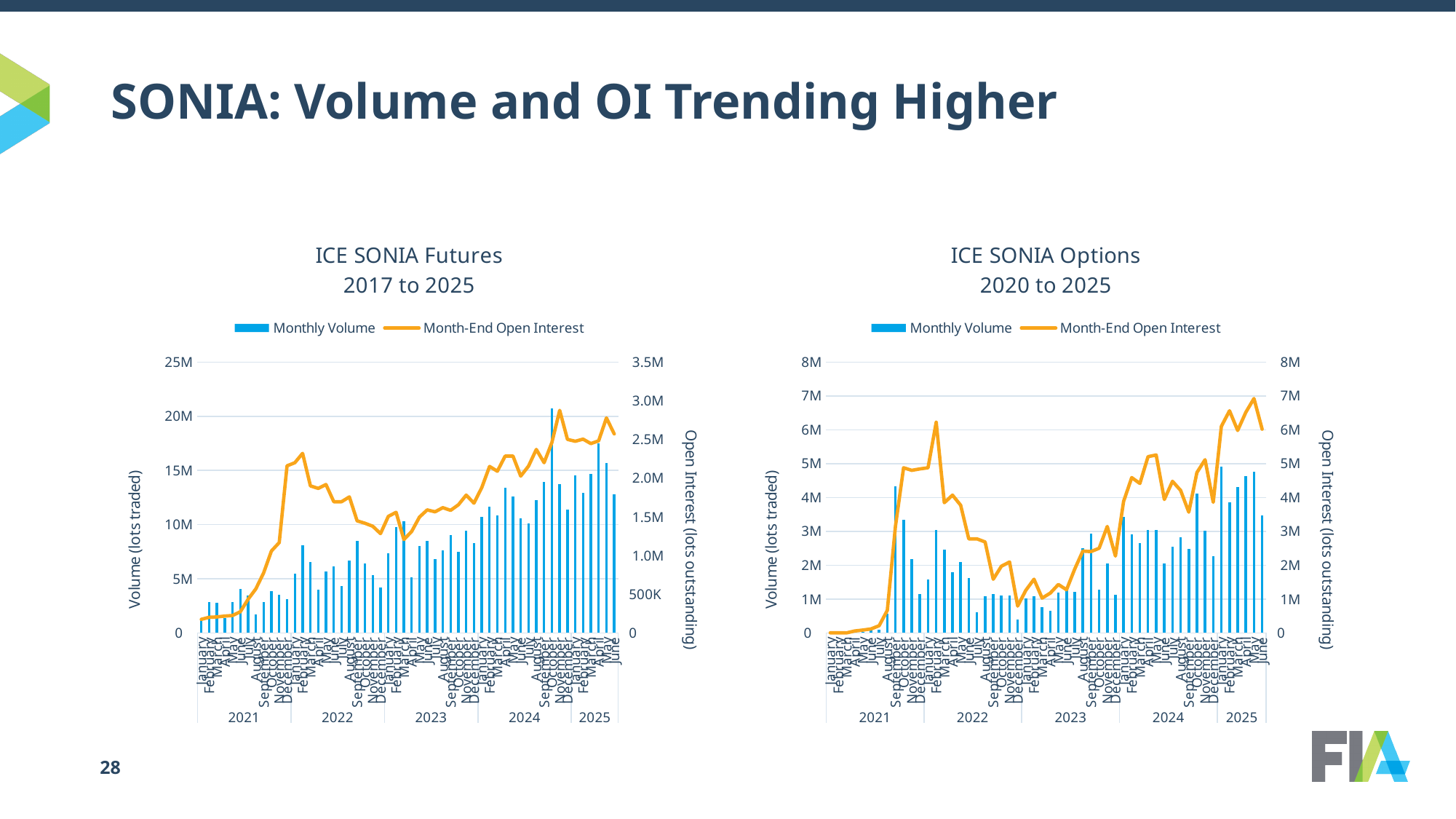
In the ICE SONIA Options chart, which series is plotted as blue bars? Monthly Volume In the ICE SONIA Options chart, is the highest Monthly Volume bar greater or less than 4M? greater How many series does the legend of the ICE SONIA Options chart list? 2 What is the maximum value shown on the left (Volume) axis of the ICE SONIA Futures chart? 25M In the ICE SONIA Options chart, is Monthly Volume in 2025 generally higher or lower than in 2022? Higher What kind of chart is the ICE SONIA Futures chart? A combination bar and line chart In the ICE SONIA Options chart, does Month-End Open Interest generally rise or fall from 2022 to 2025? Rise In the ICE SONIA Options chart, is the peak Month-End Open Interest greater or less than 6M? greater In the ICE SONIA Futures chart, is Month-End Open Interest at the start of 2021 greater or less than 500K? less In the ICE SONIA Futures chart, does Month-End Open Interest generally rise or fall from 2021 to 2025? Rise In the ICE SONIA Futures chart, which series is plotted as an orange line? Month-End Open Interest